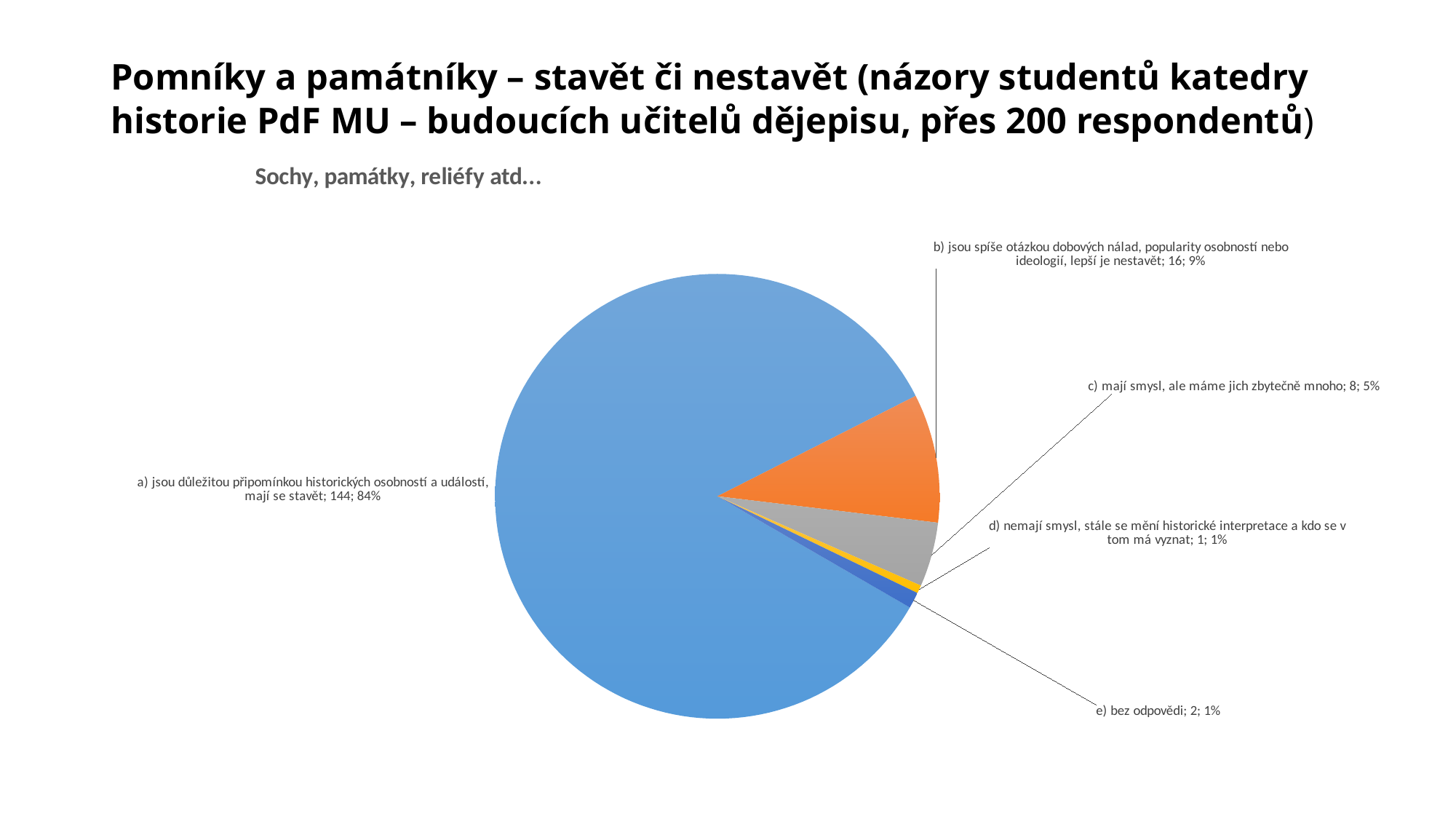
How many respondents chose option b) 'jsou spíše otázkou dobových nálad, popularity osobností nebo ideologií, lepší je nestavět'? 16 Which has more respondents, option c) 'mají smysl, ale máme jich zbytečně mnoho' or option e) 'bez odpovědi'? c) mají smysl, ale máme jich zbytečně mnoho Which option has the largest slice of the pie? a) jsou důležitou připomínkou historických osobností a událostí, mají se stavět How many respondents chose option e) 'bez odpovědi'? 2 How many respondents chose option a) 'jsou důležitou připomínkou historických osobností a událostí, mají se stavět'? 144 What is the difference in respondents between option b) and option c)? 8 How many slices does the pie chart have? 5 What percentage is shown for option c) 'mají smysl, ale máme jich zbytečně mnoho'? 5% Which option has the smallest number of respondents? d) nemají smysl, stále se mění historické interpretace a kdo se v tom má vyznat What share of the pie does option a) 'jsou důležitou připomínkou historických osobností a událostí, mají se stavět' represent? 84% What kind of chart is shown on the slide? pie chart What is the title of the chart? Sochy, památky, reliéfy atd…